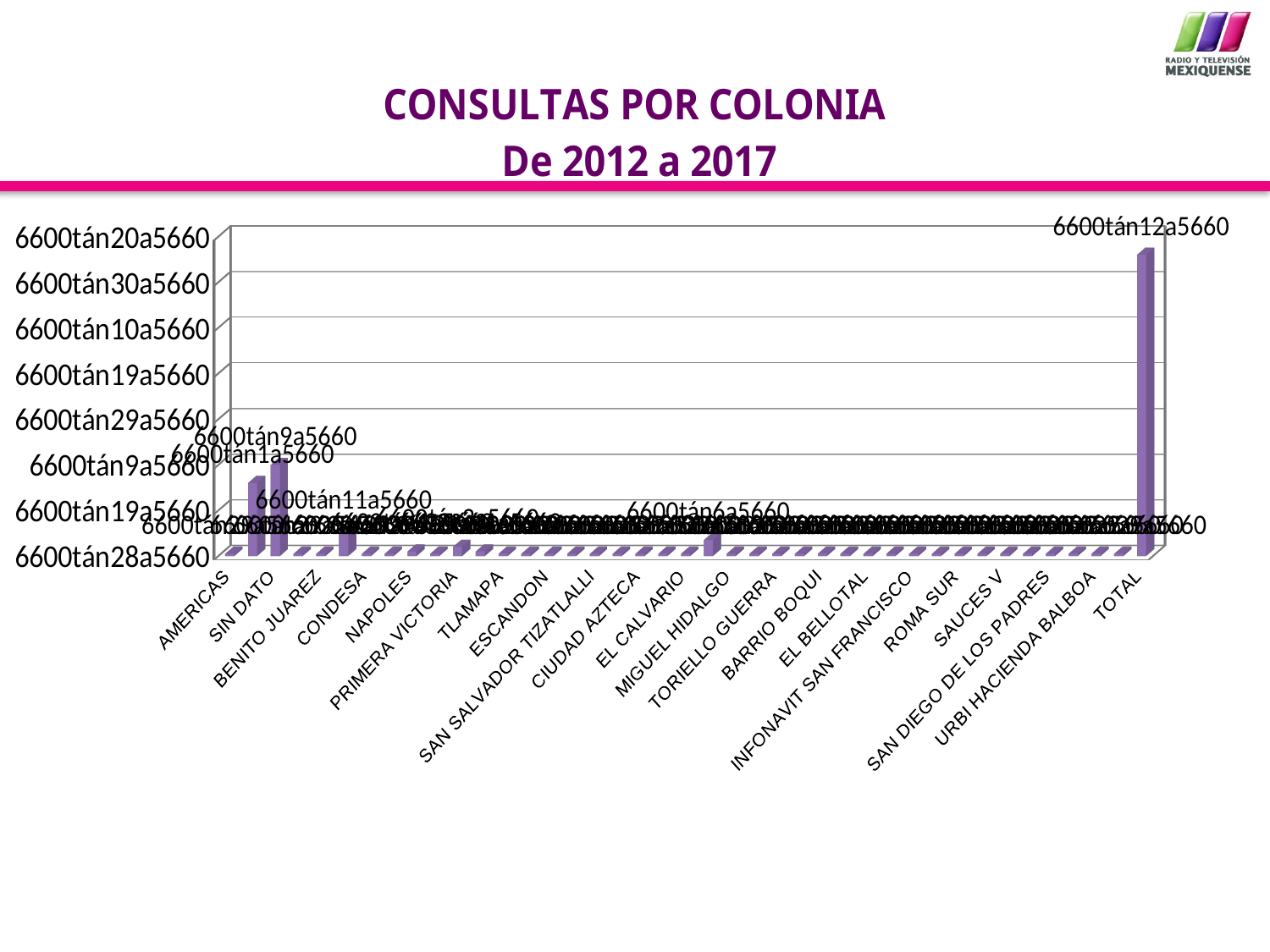
Which bar is taller, TOTAL or MIGUEL HIDALGO? TOTAL What kind of chart is shown on the slide? bar chart Which bar is taller, SIN DATO or CONDESA? SIN DATO Which bar is taller, SIN DATO or MIGUEL HIDALGO? SIN DATO What is the title of the chart on the slide? CONSULTAS POR COLONIA De 2012 a 2017 What is the first category label on the x axis of the chart? AMERICAS Which category has the tallest bar in the chart? TOTAL Which category label appears last on the x axis of the chart? TOTAL